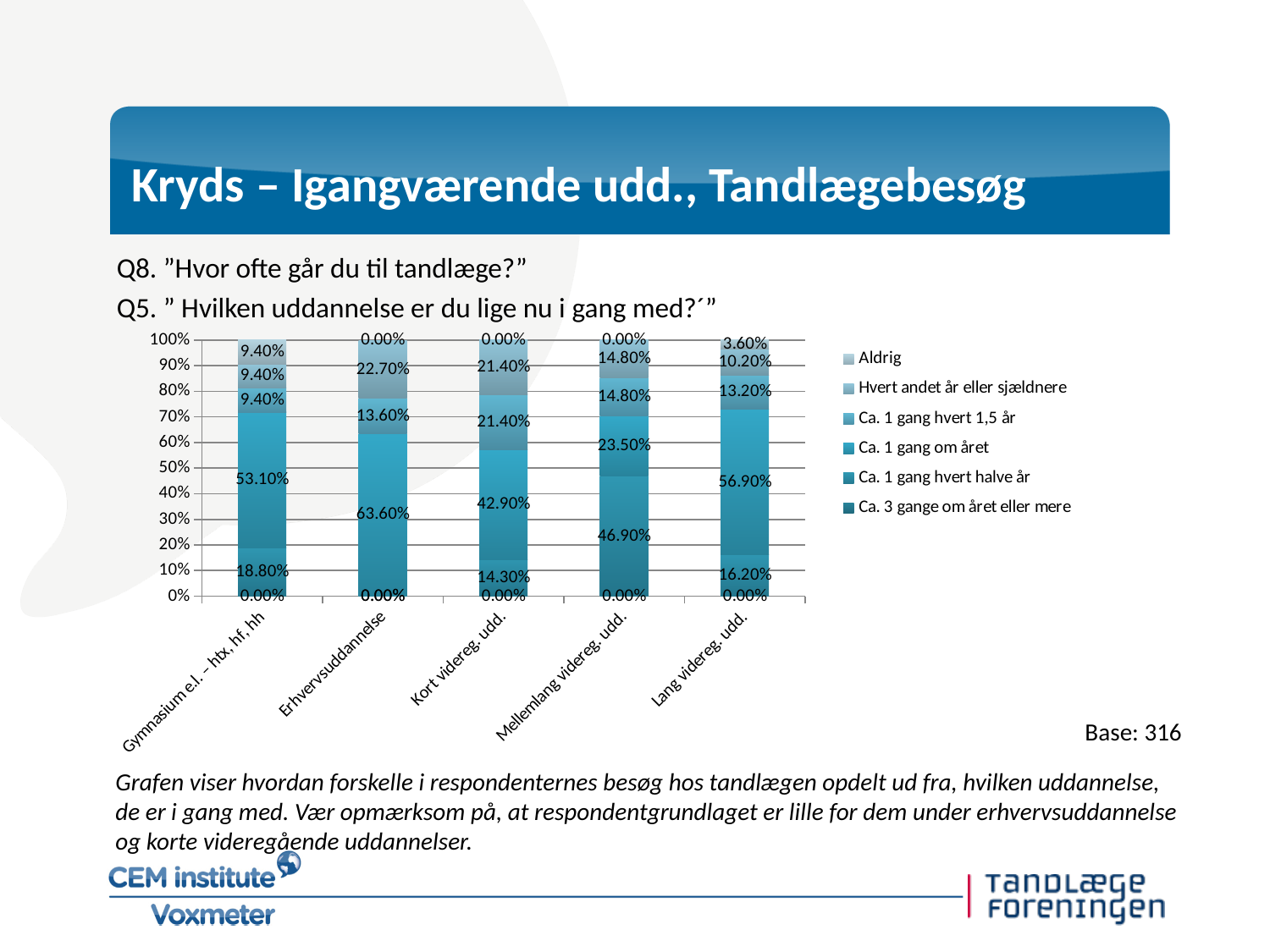
How many series does the legend list? 6 What is the value for "Ca. 1 gang hvert halve år" in the Mellemlang videreg. udd. bar? 46.90% What kind of chart is shown on the slide? Stacked bar chart What is the value for "Aldrig" in the Lang videreg. udd. bar? 3.60% Which education category has the lowest share for "Ca. 1 gang om året"? Mellemlang videreg. udd. For "Hvert andet år eller sjældnere", which is larger: Erhvervsuddannelse or Lang videreg. udd.? Erhvervsuddannelse What is the value for "Aldrig" in the Gymnasium e.l. – htx, hf, hh bar? 9.40% What is the difference in the "Ca. 1 gang om året" share between Erhvervsuddannelse and Kort videreg. udd.? 20.70 percentage points What is the value for "Ca. 1 gang om året" in the Erhvervsuddannelse bar? 63.60% Which education category has the highest share for "Ca. 1 gang hvert halve år"? Mellemlang videreg. udd. Which education category has the highest share for "Ca. 1 gang om året"? Erhvervsuddannelse How many education categories are shown on the x axis? 5